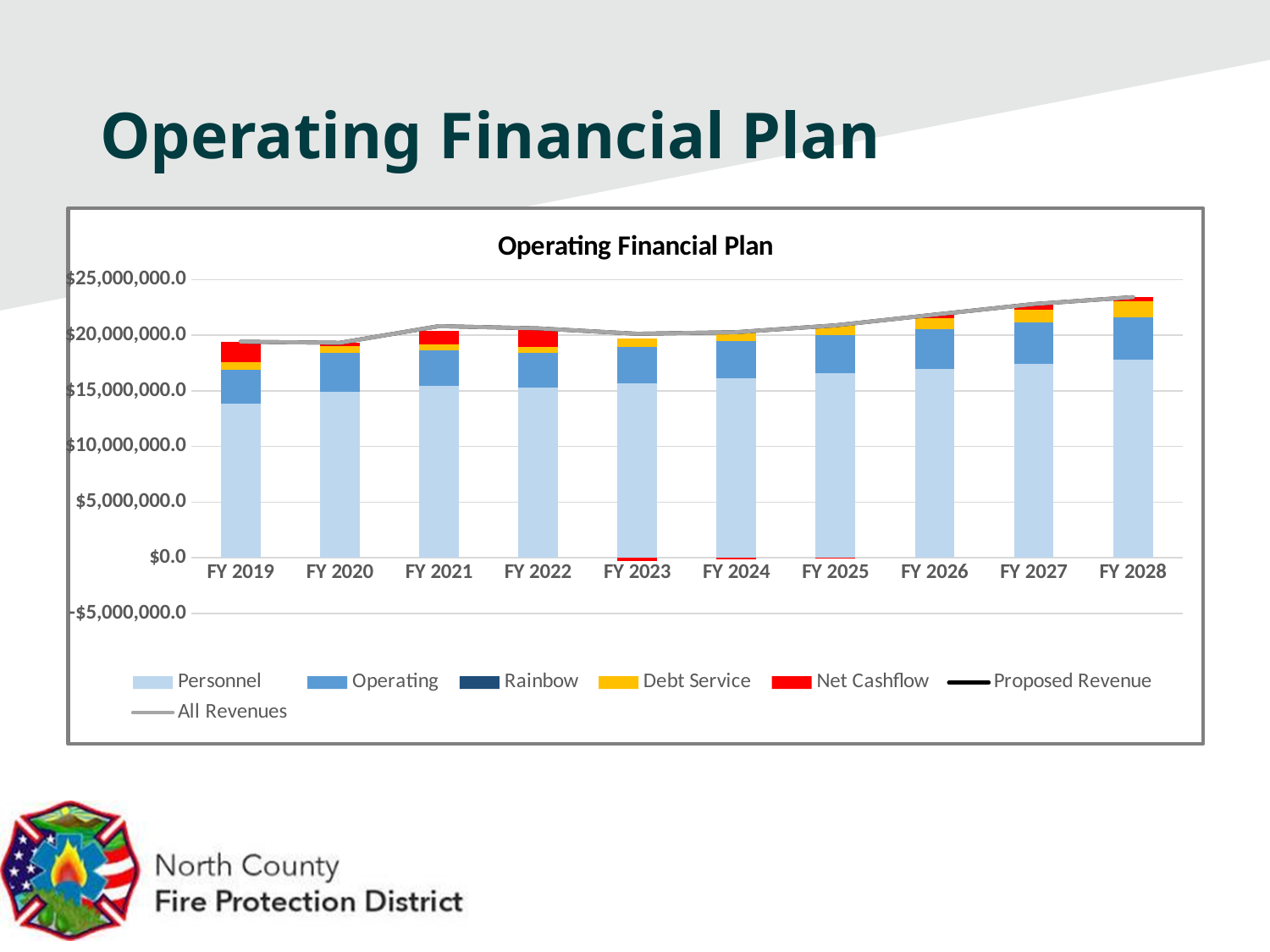
What kind of chart is shown on the slide? Stacked bar chart with line series Is the Personnel value for FY 2019 greater or less than $15,000,000.0? less What is the title of the chart? Operating Financial Plan Is the total height of the stacked bar for FY 2028 greater or less than $20,000,000.0? greater Is the Personnel value for FY 2025 greater or less than $15,000,000.0? greater Does the Personnel segment generally rise or fall from FY 2019 to FY 2028? Rise How many fiscal years are shown on the x axis? 10 In which fiscal year is the Personnel segment the largest? FY 2028 Which colour represents Net Cashflow in the legend? Red In which fiscal year is the Personnel segment the smallest? FY 2019 How many series does the legend list? 7